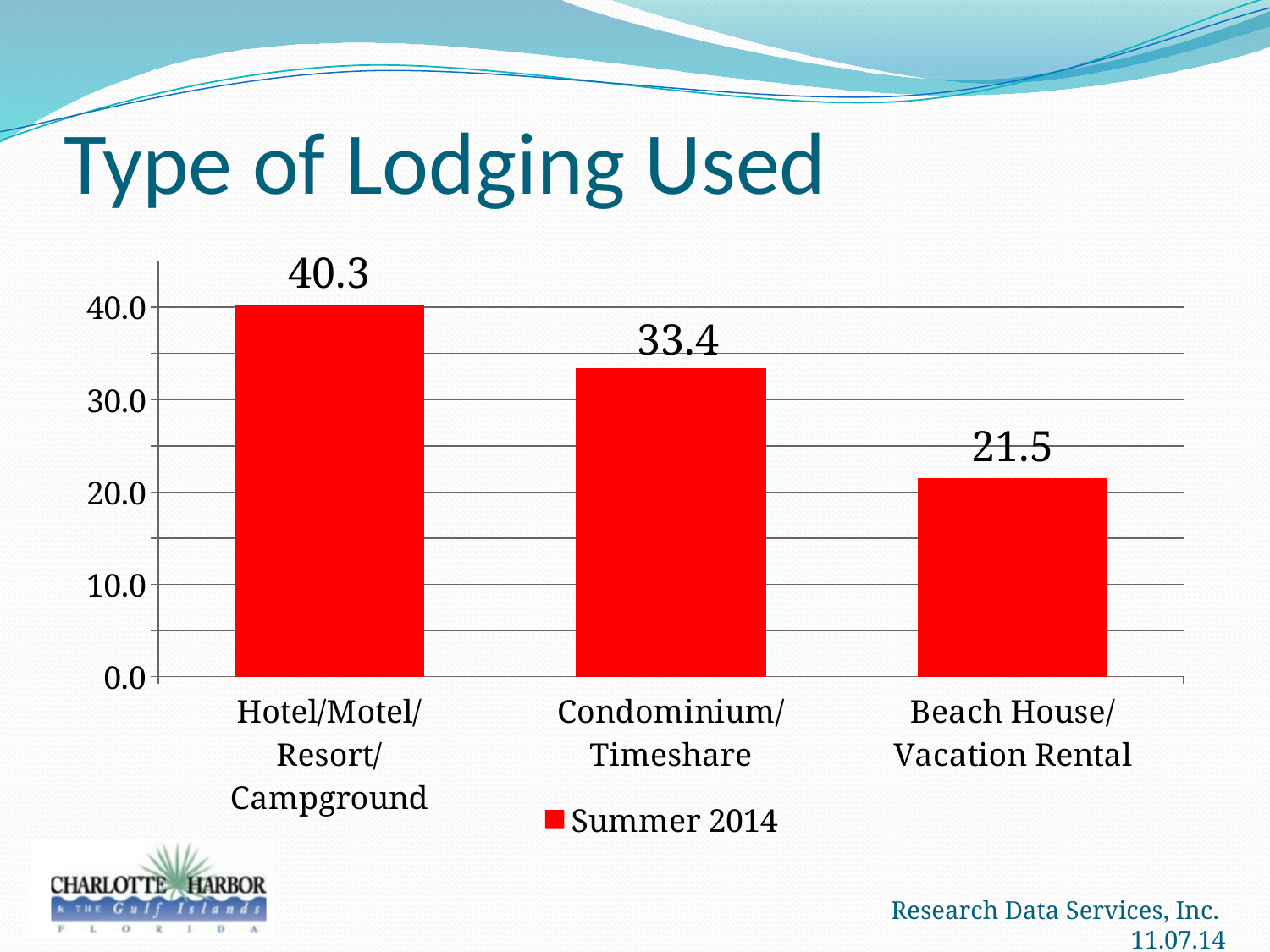
Which lodging type has the lowest value? Beach House/Vacation Rental Which is larger, the value for Condominium/Timeshare or Beach House/Vacation Rental? Condominium/Timeshare Which lodging type has the highest value? Hotel/Motel/Resort/Campground What is the value for Hotel/Motel/Resort/Campground? 40.3 Is the value for Beach House/Vacation Rental greater or less than 30.0? less What kind of chart is shown on the slide? bar chart What is the value for Beach House/Vacation Rental? 21.5 What is the difference between the values for Hotel/Motel/Resort/Campground and Condominium/Timeshare? 6.9 How many lodging categories are shown in the chart? 3 What is the difference between the values for Condominium/Timeshare and Beach House/Vacation Rental? 11.9 How many series does the legend list? 1 What is the value for Condominium/Timeshare? 33.4